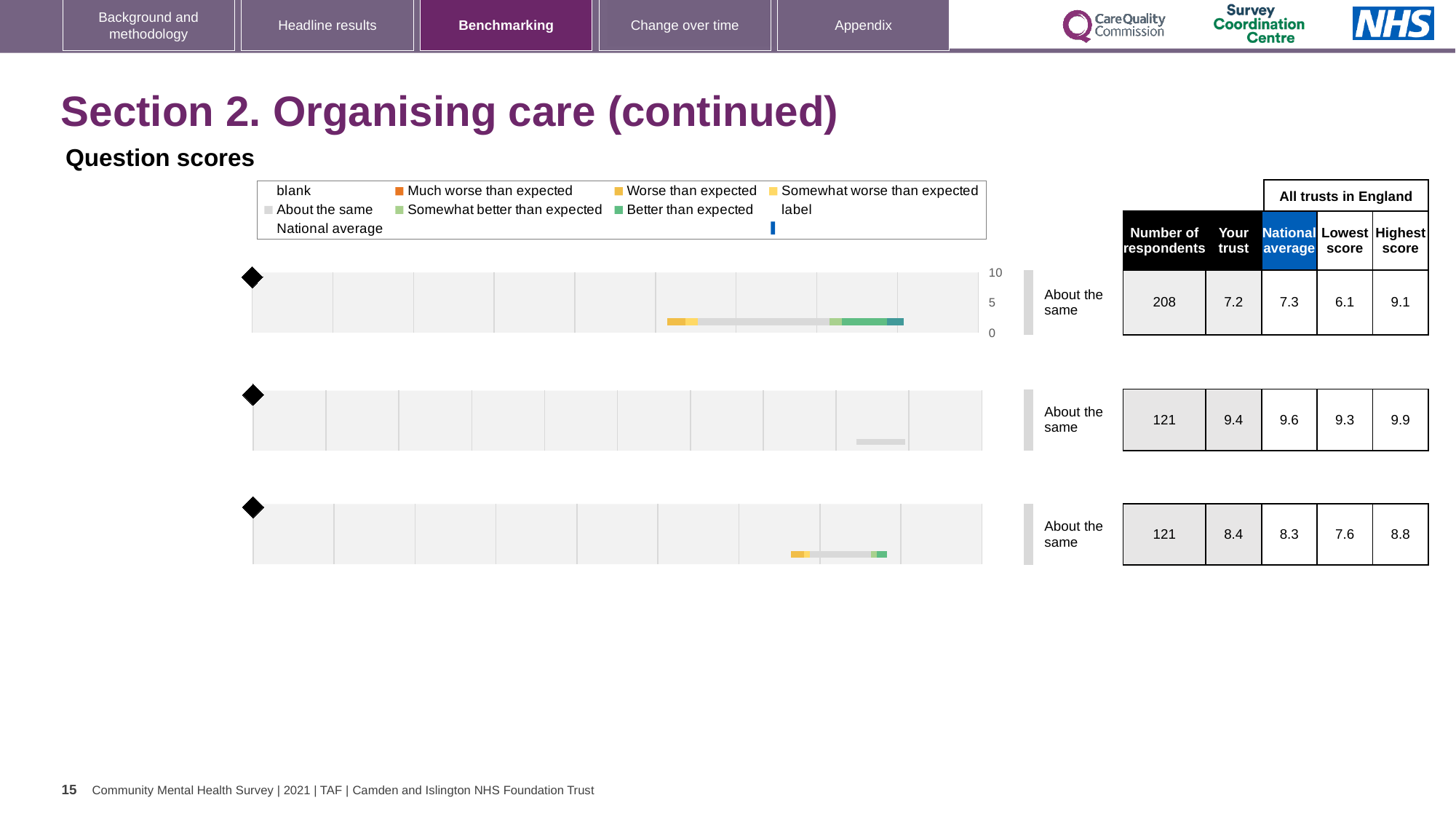
Which chart row has the highest Your trust score: top, middle or bottom? Middle How many benchmarking charts are shown on the slide? 3 What benchmark category label is shown next to the top chart? About the same In the bottom chart's row, which is larger: the Your trust score or the National average score? Your trust In the top chart's row, what is the difference between the Highest score and the Lowest score? 3.0 In the top chart's row, what is the National average score? 7.3 In the top chart's row, what is the score for Your trust? 7.2 In the bottom chart's row, what is the Lowest score among all trusts in England? 7.6 In the middle chart's row, what is the Highest score among all trusts in England? 9.9 In the middle chart's row, how much higher is the National average than the Your trust score? 0.2 In the middle chart's row, what is the Number of respondents? 121 What kind of chart is used for the benchmarking displays on this slide? Bar chart